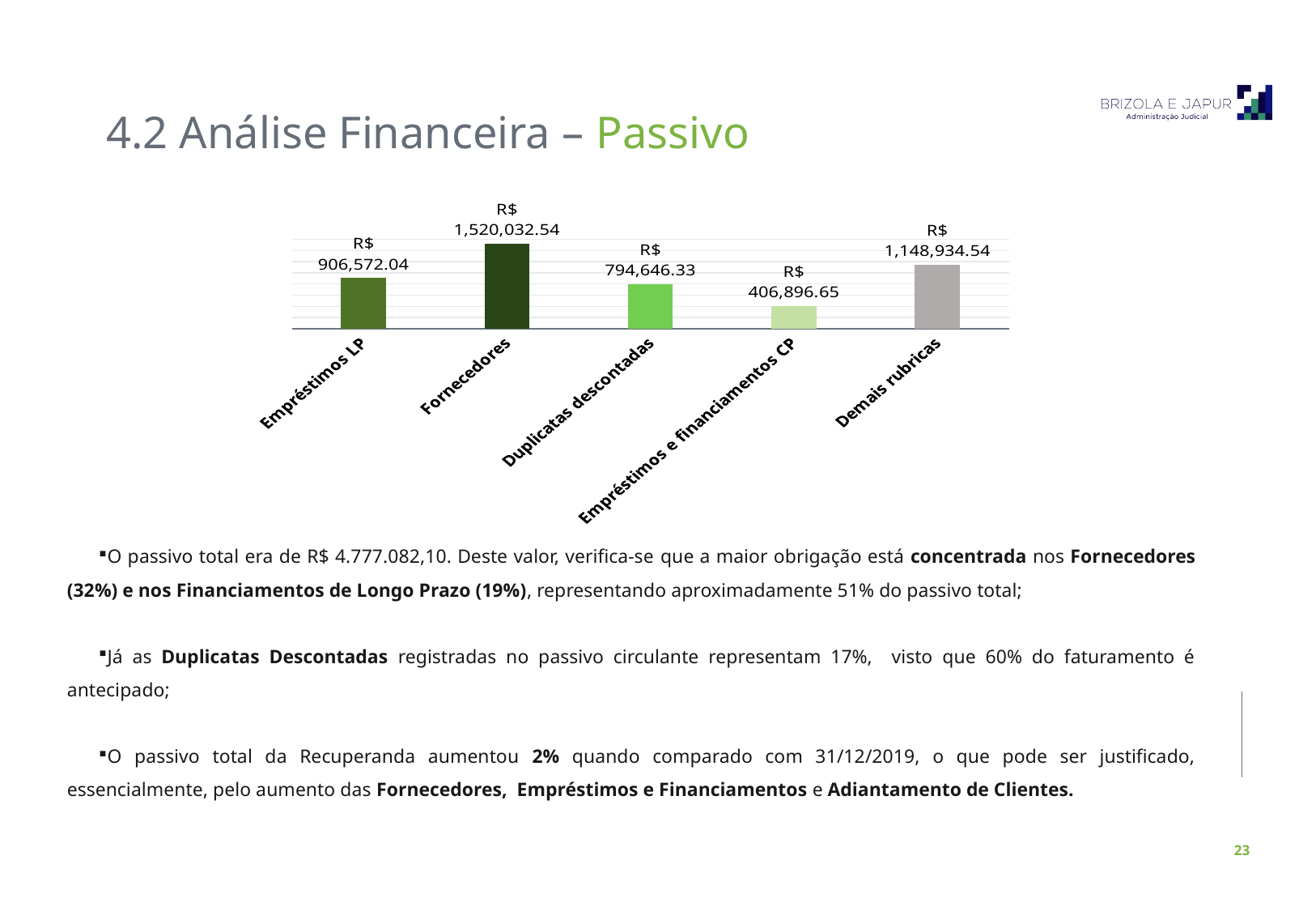
What is the value for Fornecedores? R$ 1,520,032.54 What is the value for Duplicatas descontadas? R$ 794,646.33 How many categories are shown in the chart? 5 Which category has the lowest value? Empréstimos e financiamentos CP What is the value for Empréstimos LP? R$ 906,572.04 What kind of chart is shown on the slide? Bar chart Which is larger, the value for Demais rubricas or the value for Empréstimos LP? Demais rubricas What is the value for Empréstimos e financiamentos CP? R$ 406,896.65 What is the difference between the values for Demais rubricas and Duplicatas descontadas? R$ 354,288.21 What is the value for Demais rubricas? R$ 1,148,934.54 Which category has the highest value? Fornecedores What is the difference between the values for Fornecedores and Empréstimos LP? R$ 613,460.50